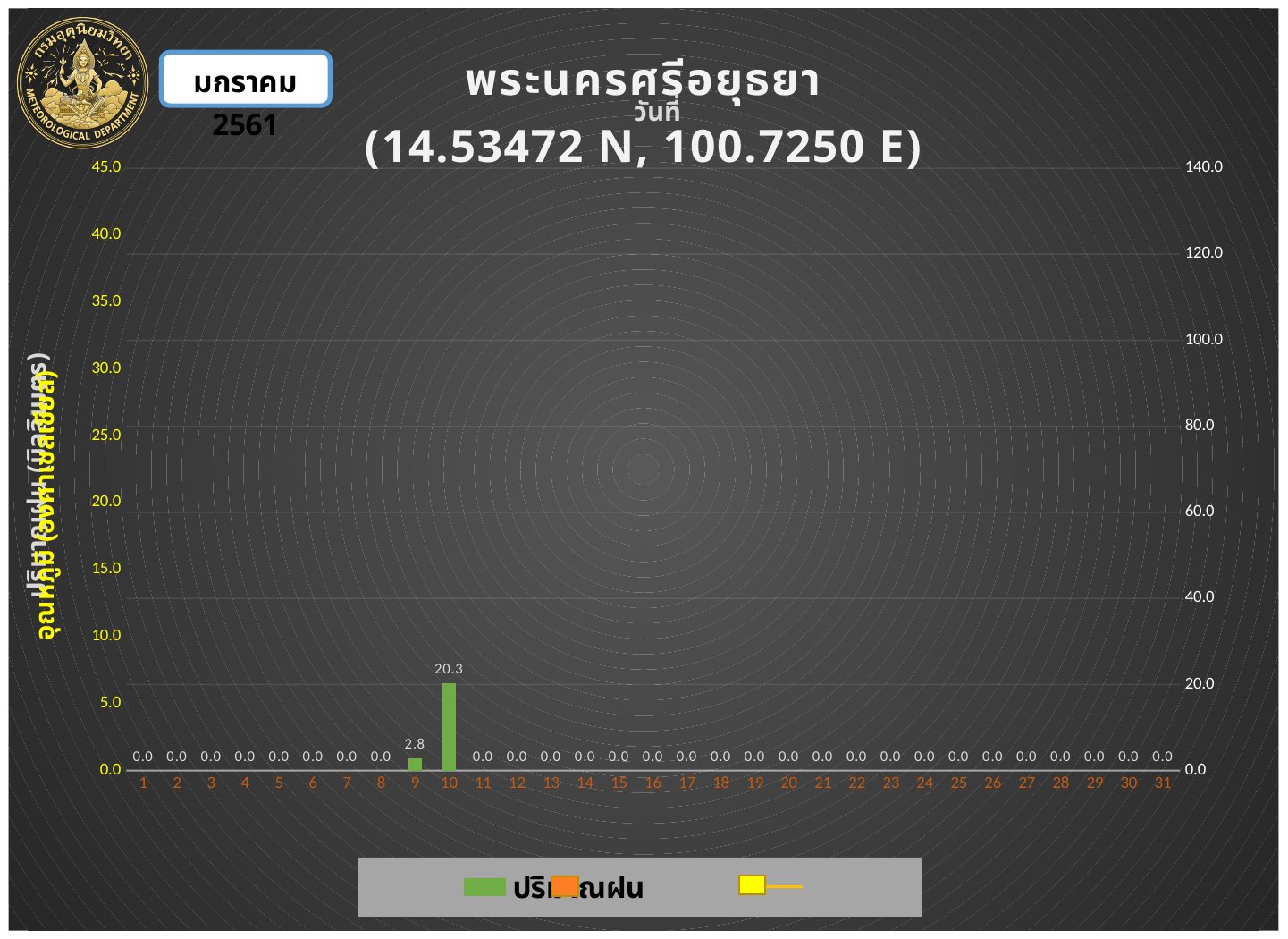
What is the maximum value shown on the right-hand axis? 140.0 Is the value for day 10 greater or less than 5.0 on the left axis? greater What is the rainfall value shown for day 10? 20.3 What is the value shown for day 15? 0.0 What is the difference between the values for day 10 and day 9? 17.5 What kind of chart is this? bar chart How many days have a non-zero value? 2 How many days are shown on the x axis? 31 Which day has the highest rainfall value? 10 What is the rainfall value shown for day 9? 2.8 Which is larger, the value for day 9 or the value for day 10? day 10 What colour are the rainfall bars? green